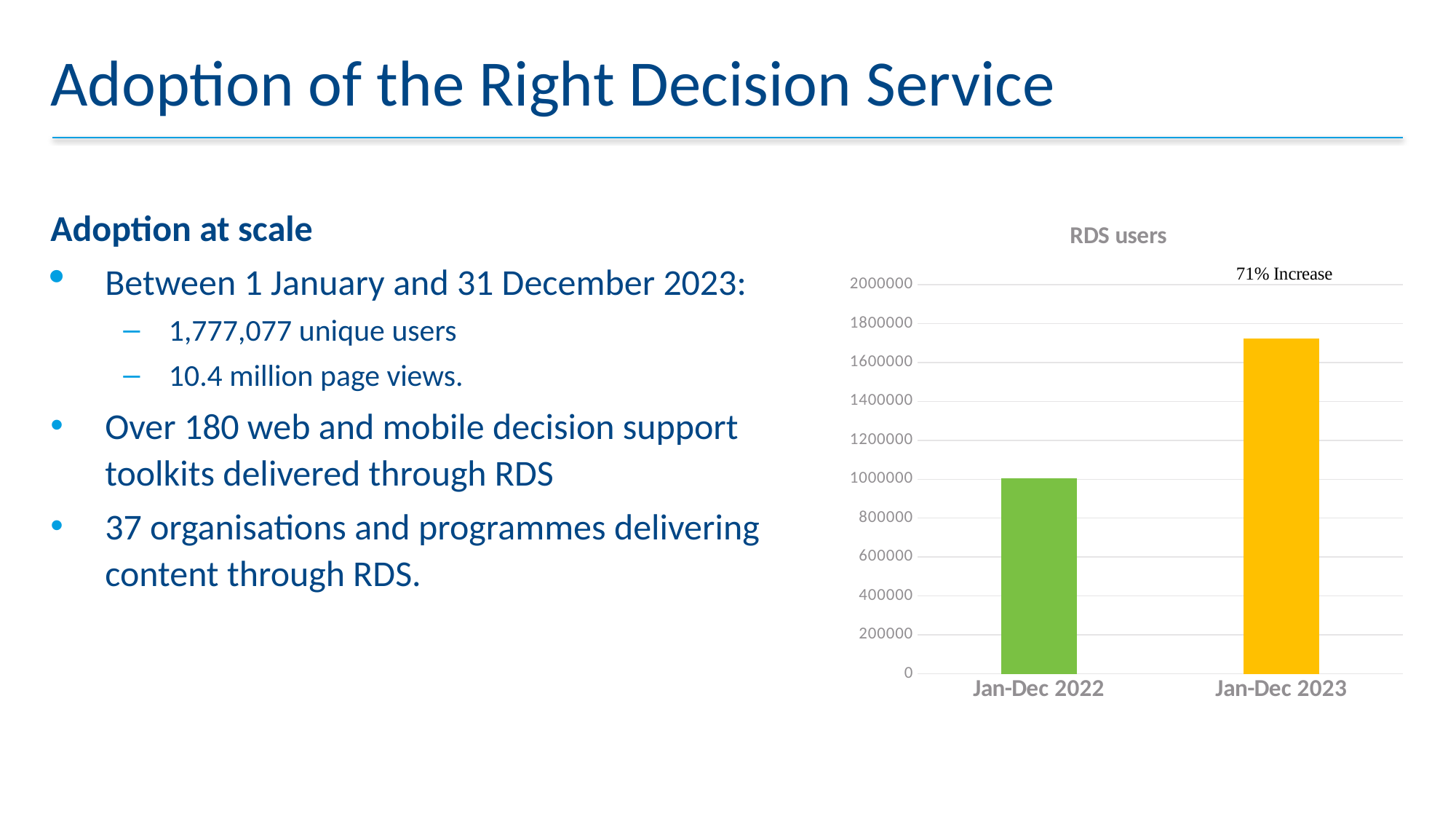
What is the title of the chart? RDS users What percentage increase is annotated above the Jan-Dec 2023 bar? 71% Increase Which is larger, the value for Jan-Dec 2022 or Jan-Dec 2023? Jan-Dec 2023 What kind of chart is shown on the slide? Bar chart Which period has the lowest number of RDS users? Jan-Dec 2022 Is the value for Jan-Dec 2023 greater or less than 1600000? greater Is the value for Jan-Dec 2022 greater or less than 800000? greater Which period has the highest number of RDS users? Jan-Dec 2023 How many bars are plotted in the RDS users chart? 2 Do RDS users rise or fall from Jan-Dec 2022 to Jan-Dec 2023? Rise Is the value for Jan-Dec 2022 greater or less than 1200000? less